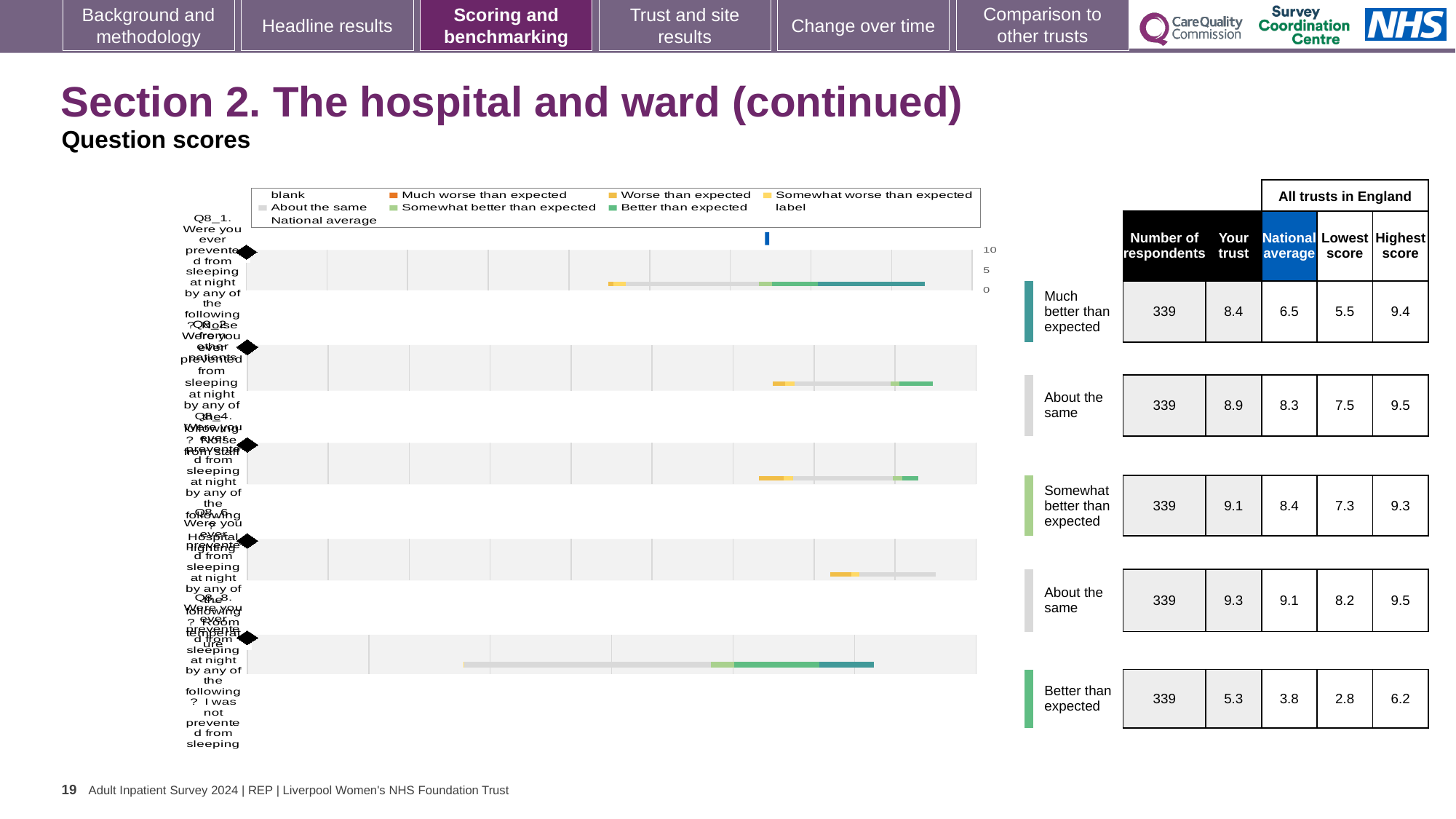
How many question rows (bars) does the chart show? 5 What is the 'Your trust' score for the first row, rated 'Much better than expected'? 8.4 For the first row, rated 'Much better than expected', what is the difference between the 'Your trust' score and the national average? 1.9 How many respondents are listed for the row rated 'Somewhat better than expected'? 339 What kind of chart is shown on the slide? bar chart What is the national average for the first row, rated 'Much better than expected'? 6.5 What is the highest score among all trusts in England for the last row, rated 'Better than expected'? 6.2 What is the 'Your trust' score for the last row, rated 'Better than expected'? 5.3 For the row rated 'Somewhat better than expected', which is larger: the 'Your trust' score or the national average? Your trust Which row has the lowest 'Your trust' score? the last row (Better than expected), 5.3 Which row has the highest 'Your trust' score? the fourth row (About the same), 9.3 What is the subtitle given for the chart on this slide? Question scores